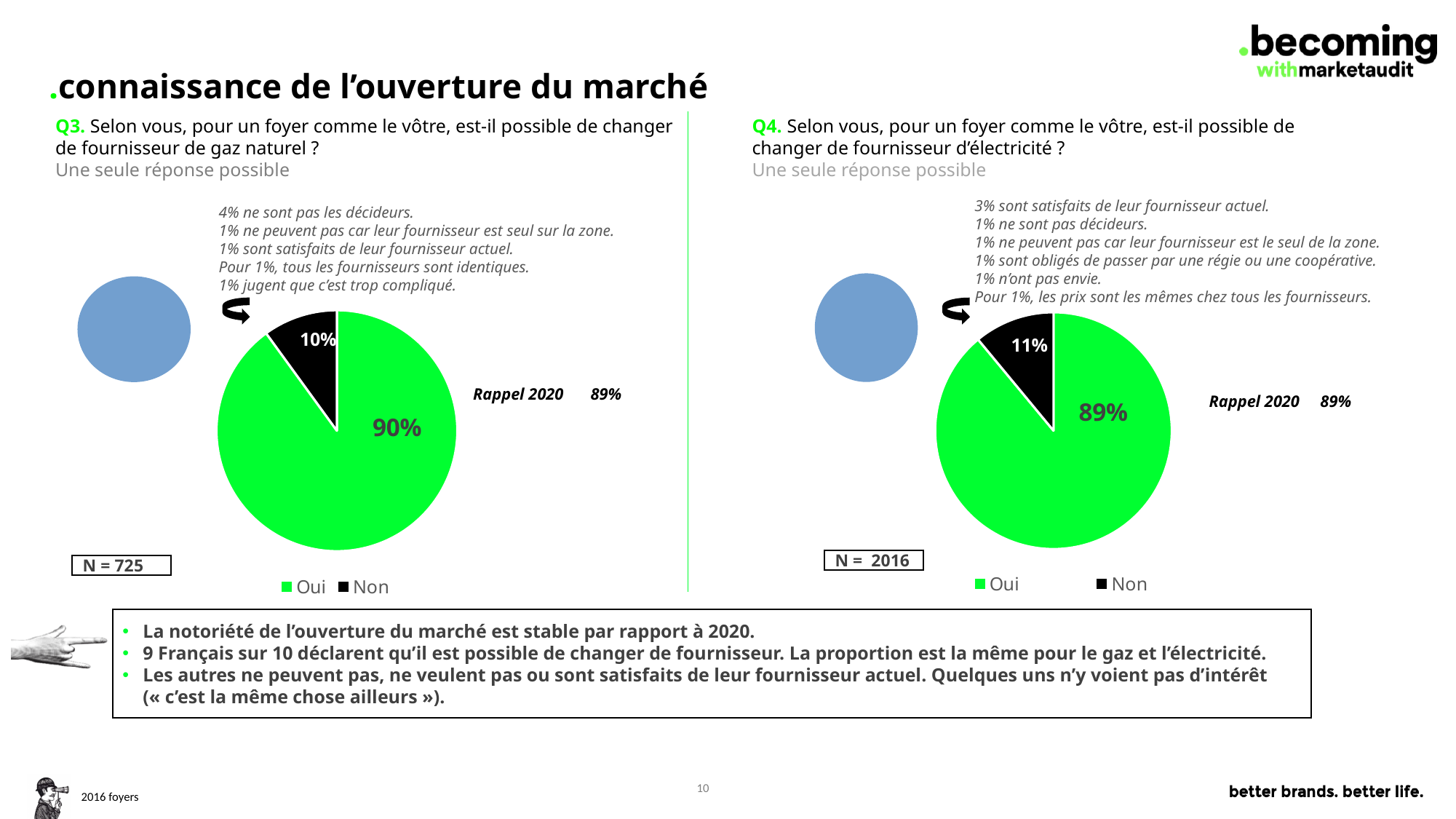
In the left pie chart (Q3, gaz naturel), what share of respondents answered "Oui"? 90% In the left pie chart (Q3, gaz naturel), which response has the largest slice? Oui In the right pie chart (Q4, électricité), what share of respondents answered "Non"? 11% In the left pie chart (Q3, gaz naturel), what share of respondents answered "Non"? 10% What type of chart is used for Q3 and Q4 on this slide? Pie chart What colour represents "Oui" in the pie charts? Green What is the "Rappel 2020" value shown next to the right pie chart (Q4, électricité)? 89% Is the "Non" share larger in the left pie chart (Q3) or in the right pie chart (Q4)? Right pie chart (Q4) How many entries does the legend of the left pie chart (Q3) list? 2 In the right pie chart (Q4, électricité), what share of respondents answered "Oui"? 89% In the left pie chart (Q3, gaz naturel), what is the difference between the "Oui" and "Non" shares? 80% In the right pie chart (Q4, électricité), which response has the smallest slice? Non